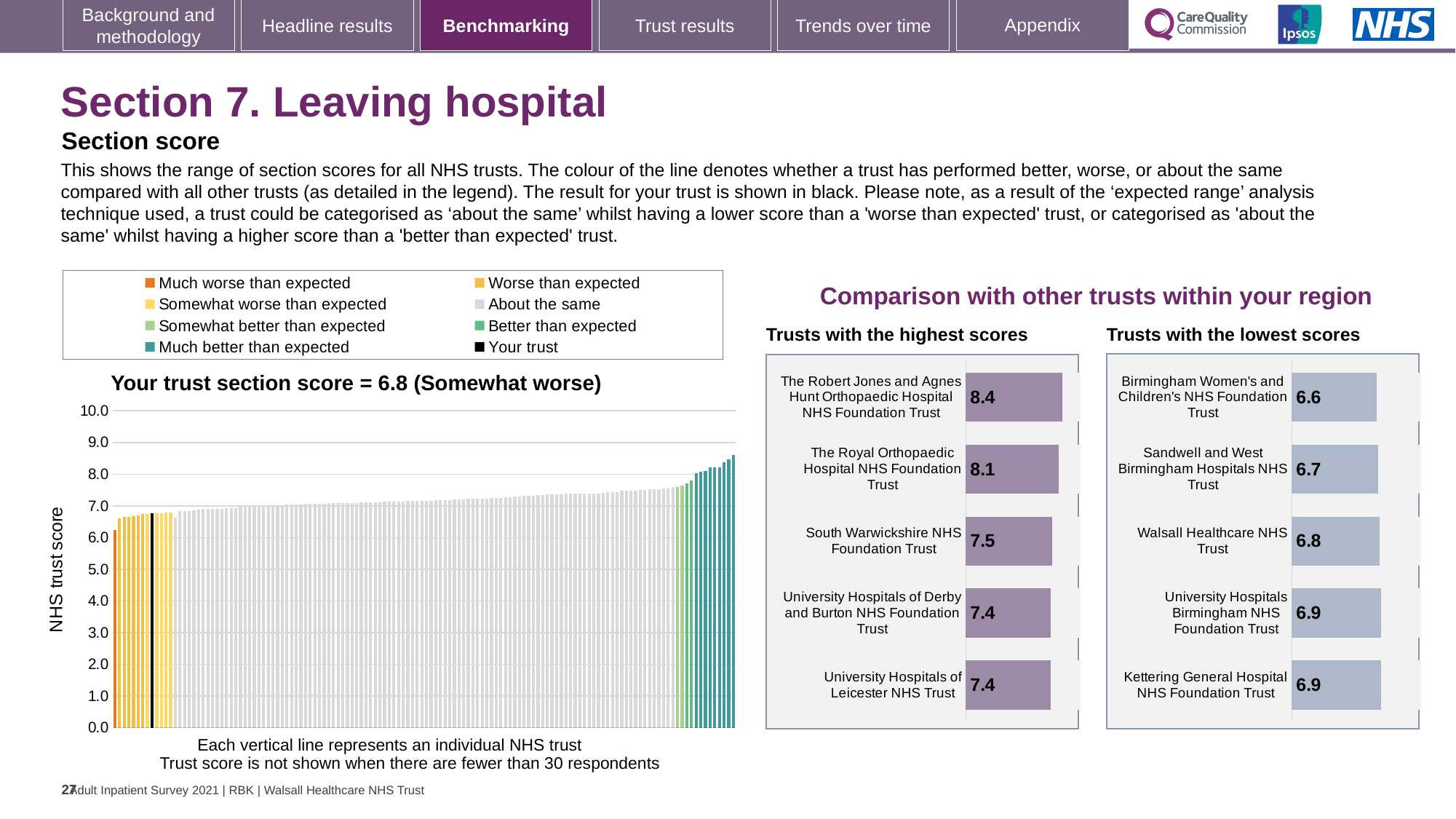
How many trusts are shown on the 'Trusts with the lowest scores' chart? 5 On the 'Your trust section score' chart, what is the section score for your trust? 6.8 On the 'Trusts with the lowest scores' chart, which has the larger score: Sandwell and West Birmingham Hospitals NHS Trust or Walsall Healthcare NHS Trust? Walsall Healthcare NHS Trust What is the label on the vertical axis of the 'Your trust section score' chart? NHS trust score What kind of chart is the 'Your trust section score' chart on the left of the slide? bar chart On the 'Your trust section score' chart, is the value of the tallest bar greater or less than 8.0? greater On the 'Trusts with the highest scores' chart, which trust has the highest score? The Robert Jones and Agnes Hunt Orthopaedic Hospital NHS Foundation Trust On the 'Trusts with the highest scores' chart, what is the difference between the scores of The Robert Jones and Agnes Hunt Orthopaedic Hospital NHS Foundation Trust and The Royal Orthopaedic Hospital NHS Foundation Trust? 0.3 On the 'Your trust section score' chart, do the bars rise or fall from left to right along the x axis? rise On the 'Trusts with the highest scores' chart, what is the score for The Robert Jones and Agnes Hunt Orthopaedic Hospital NHS Foundation Trust? 8.4 How many entries does the legend above the 'Your trust section score' chart list? 8 On the 'Trusts with the lowest scores' chart, which trust has the lowest score? Birmingham Women's and Children's NHS Foundation Trust